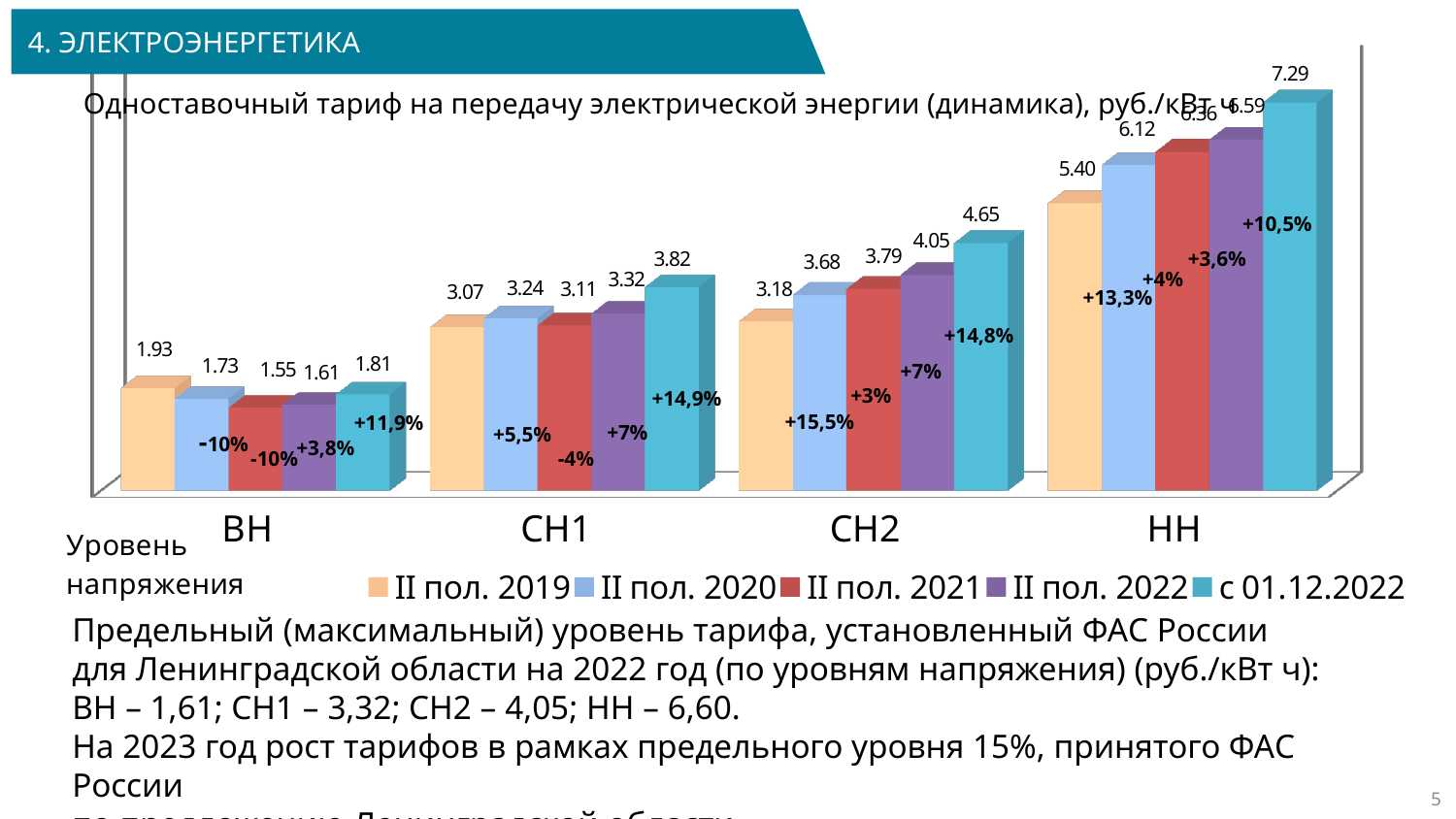
Which category has the lowest value in the series II пол. 2021? ВН What percentage change label is shown on the с 01.12.2022 bar for НН? +10,5% What type of chart is shown on the slide? bar chart What is the value for СН2 in the series II пол. 2022? 4.05 Which is larger for ВН: the II пол. 2019 value or the II пол. 2020 value? II пол. 2019 How many voltage-level categories are shown on the x axis? 4 What is the difference between the с 01.12.2022 value and the II пол. 2019 value for СН2? 1.47 Which category has the highest value in the series с 01.12.2022? НН What is the value for НН in the series с 01.12.2022? 7.29 What is the value for СН1 in the series с 01.12.2022? 3.82 How many series does the legend list? 5 What is the value for ВН in the series II пол. 2019? 1.93